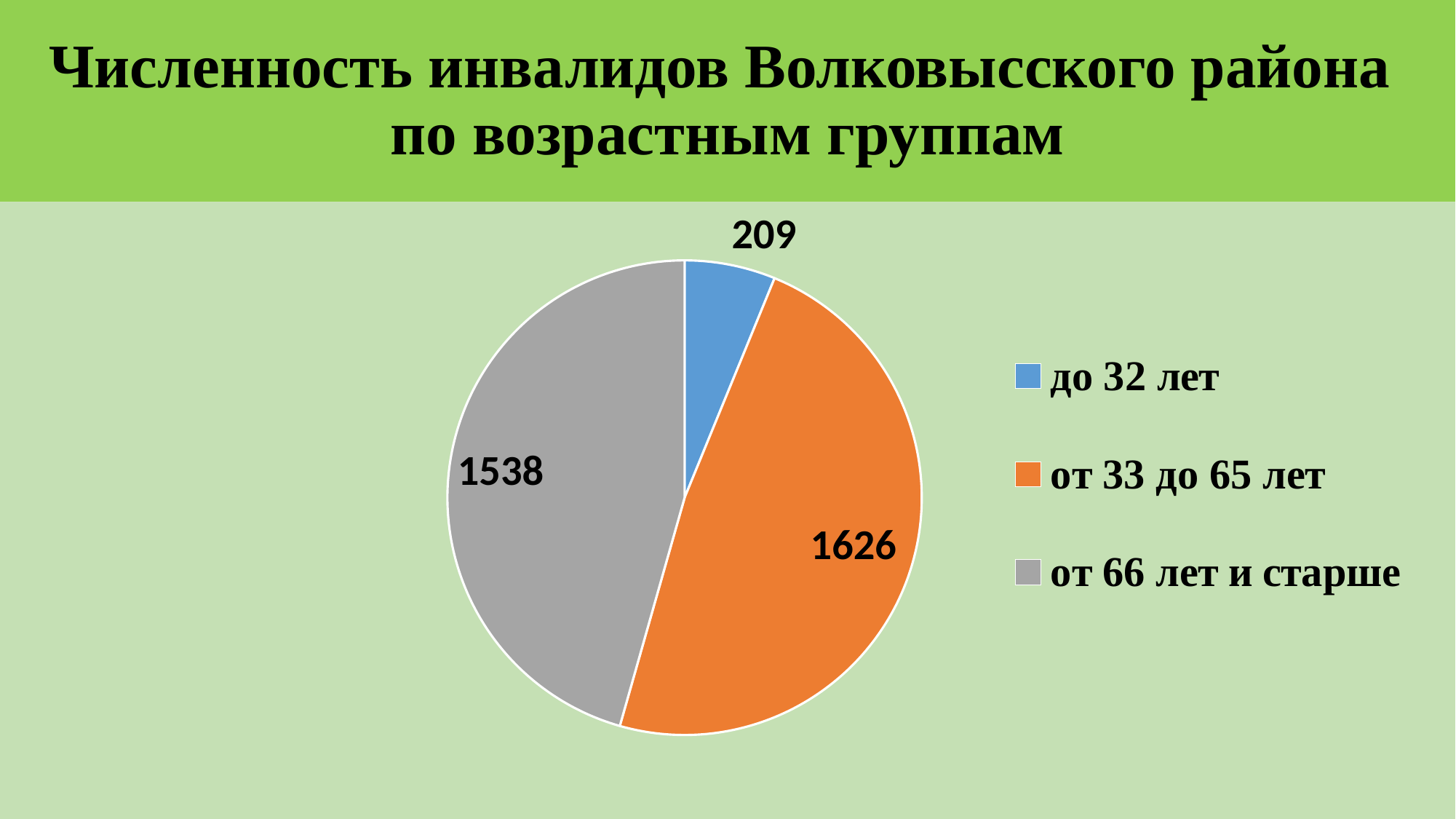
What is the difference between the values for 'от 66 лет и старше' and 'до 32 лет'? 1329 What is the value for the 'до 32 лет' slice? 209 How many slices does the pie chart have? 3 What type of chart is shown on the slide? Pie chart What is the total of all slices in the pie chart? 3373 Which age group has the smallest number of disabled people? до 32 лет Which age group has the largest number of disabled people? от 33 до 65 лет Which is larger: the value for 'от 66 лет и старше' or the value for 'до 32 лет'? от 66 лет и старше What colour is the slice for 'от 66 лет и старше'? Grey What is the difference between the values for 'от 33 до 65 лет' and 'от 66 лет и старше'? 88 What is the value for the 'от 33 до 65 лет' slice? 1626 What is the value for the 'от 66 лет и старше' slice? 1538